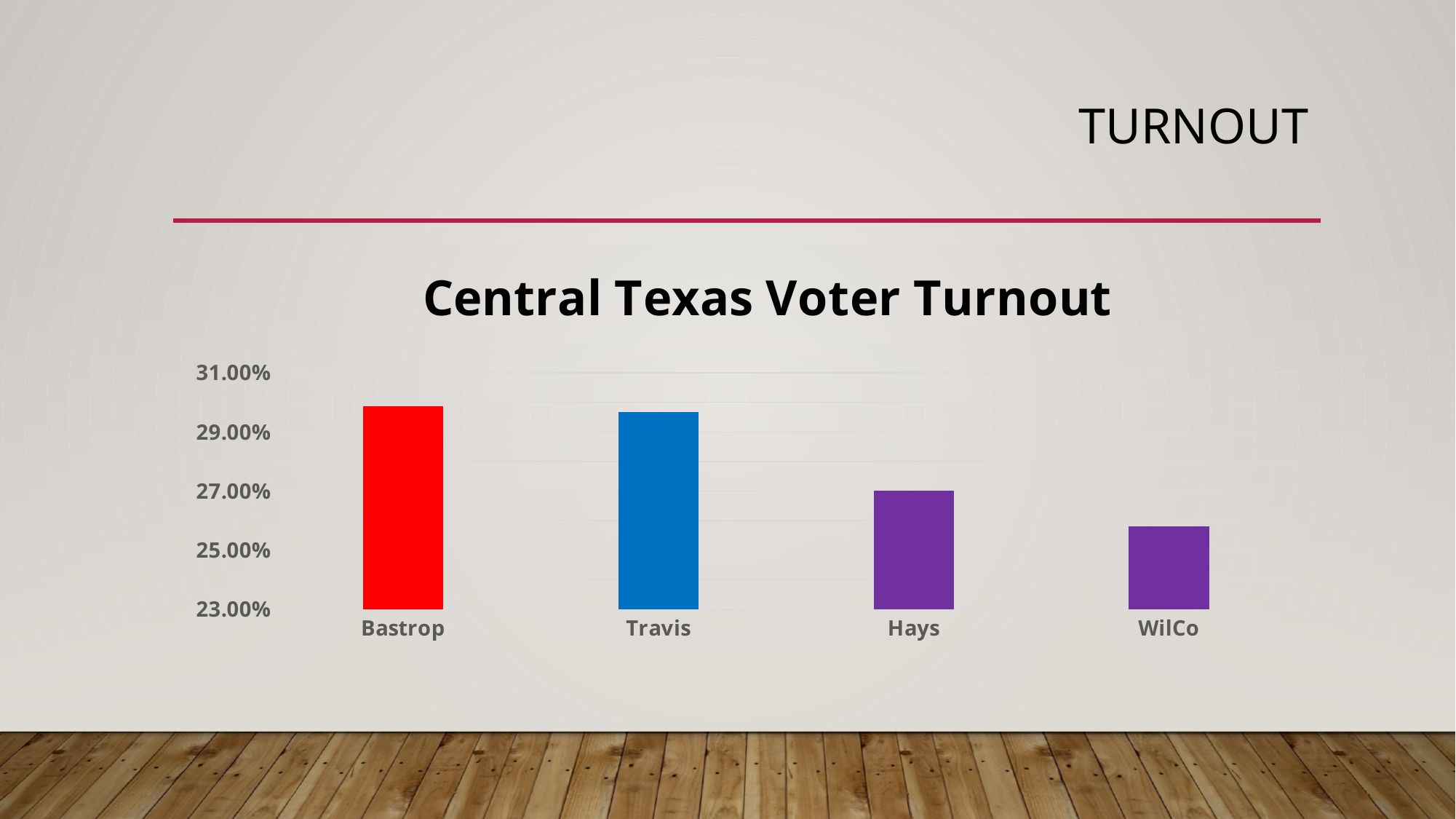
Which has the higher voter turnout, Travis or Hays? Travis Which county has the lowest voter turnout in the chart? WilCo What kind of chart is shown on the slide? bar chart What is the title of the chart? Central Texas Voter Turnout Do the turnout values rise or fall moving from Bastrop to WilCo along the x axis? fall Is the value for Hays greater or less than 29.00%? less Is the value for Travis greater or less than 29.00%? greater Is the value for Bastrop greater or less than 29.00%? greater What colour is the bar for Bastrop? red How many counties are shown on the x axis of the chart? 4